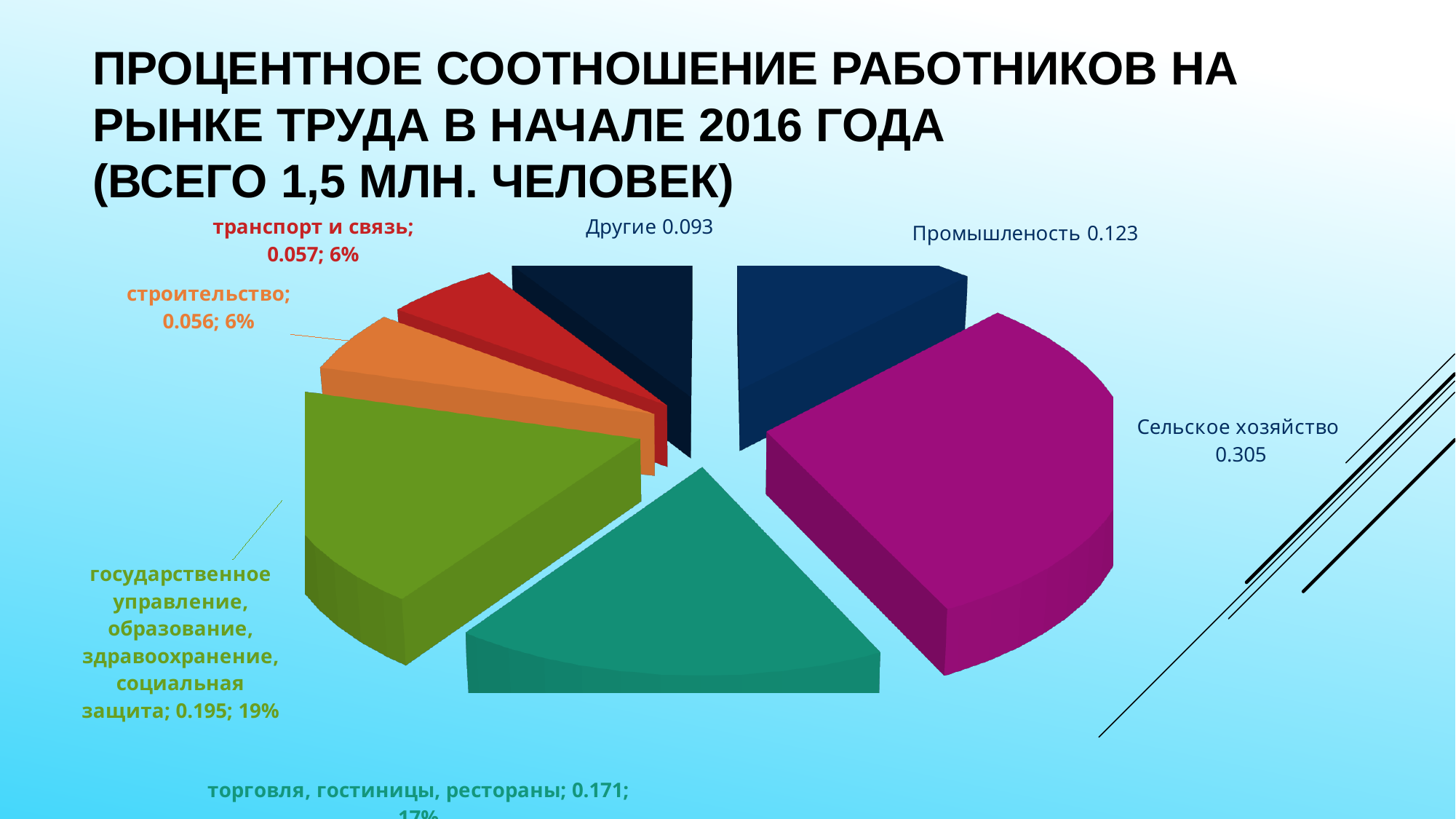
What is the value for Другие? 0.093 What percentage share of the pie is labelled for государственное управление, образование, здравоохранение, социальная защита? 19% What total number of people does the slide title say the chart covers? 1,5 млн. человек What percentage share of the pie is labelled for торговля, гостиницы, рестораны? 17% How many slices does the pie chart have? 7 What is the value for Промышленость? 0.123 Which category has the largest slice of the pie? Сельское хозяйство Which is larger, the value for Промышленость or the value for Другие? Промышленость What is the value for транспорт и связь? 0.057 What is the value for Сельское хозяйство? 0.305 What kind of chart is shown on the slide? pie chart What is the difference between the values for Сельское хозяйство and Промышленость? 0.182